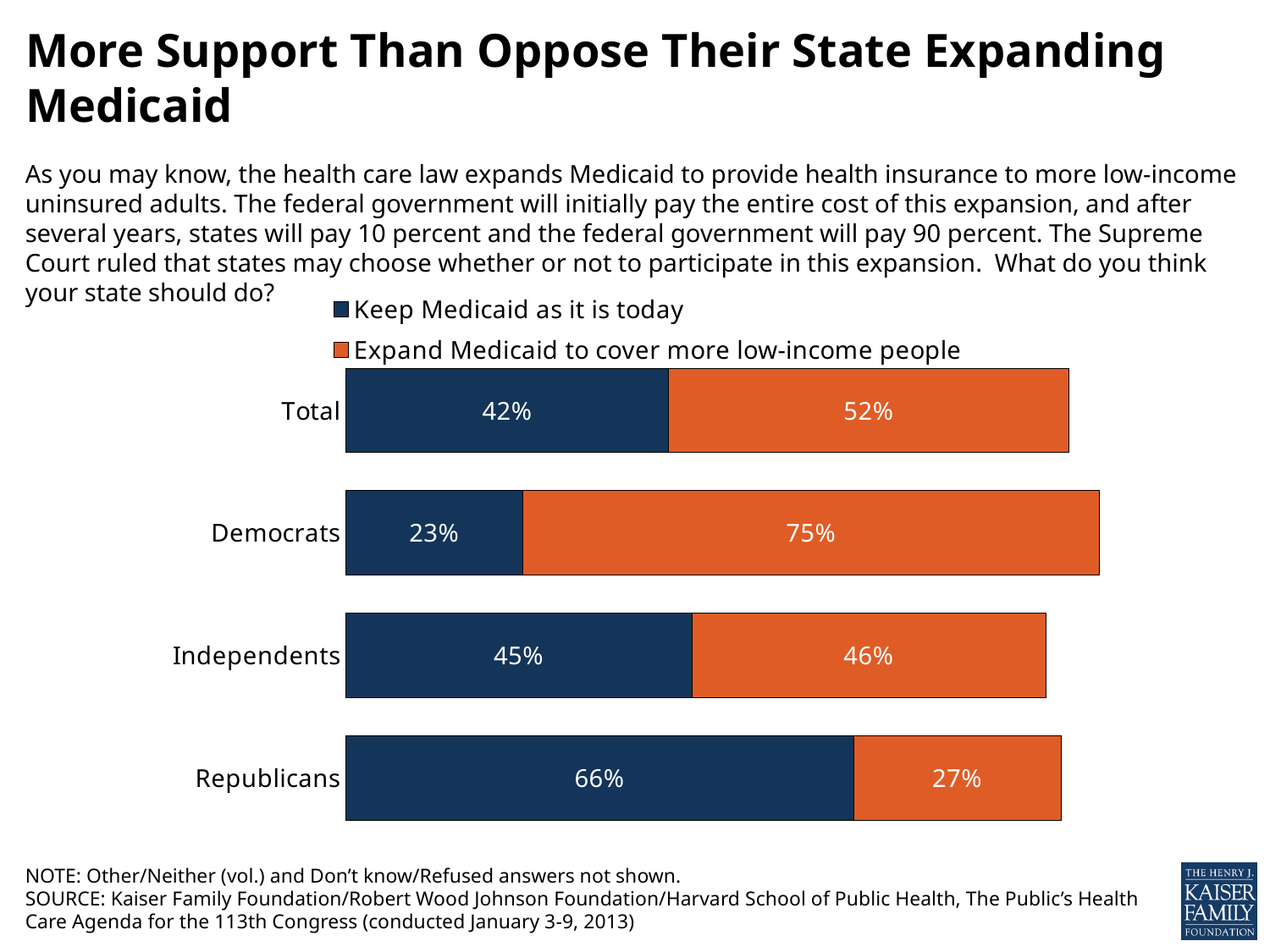
What is the value for Total in the 'Expand Medicaid to cover more low-income people' series? 52% What is the value for Independents in the 'Keep Medicaid as it is today' series? 45% Which group has the highest share saying 'Expand Medicaid to cover more low-income people'? Democrats Among Republicans, which is larger: the share saying 'Keep Medicaid as it is today' or the share saying 'Expand Medicaid to cover more low-income people'? Keep Medicaid as it is today What percentage of Democrats say their state should expand Medicaid to cover more low-income people? 75% What percentage of Republicans say their state should keep Medicaid as it is today? 66% What kind of chart is shown on the slide? Stacked bar chart What is the combined total of the two segments in the Total bar? 94% How many series does the legend list? 2 How many groups (categories) are shown on the chart? 4 What is the difference between the share of Democrats and the share of Republicans who say 'Expand Medicaid to cover more low-income people'? 48 percentage points Which group has the lowest share saying 'Keep Medicaid as it is today'? Democrats